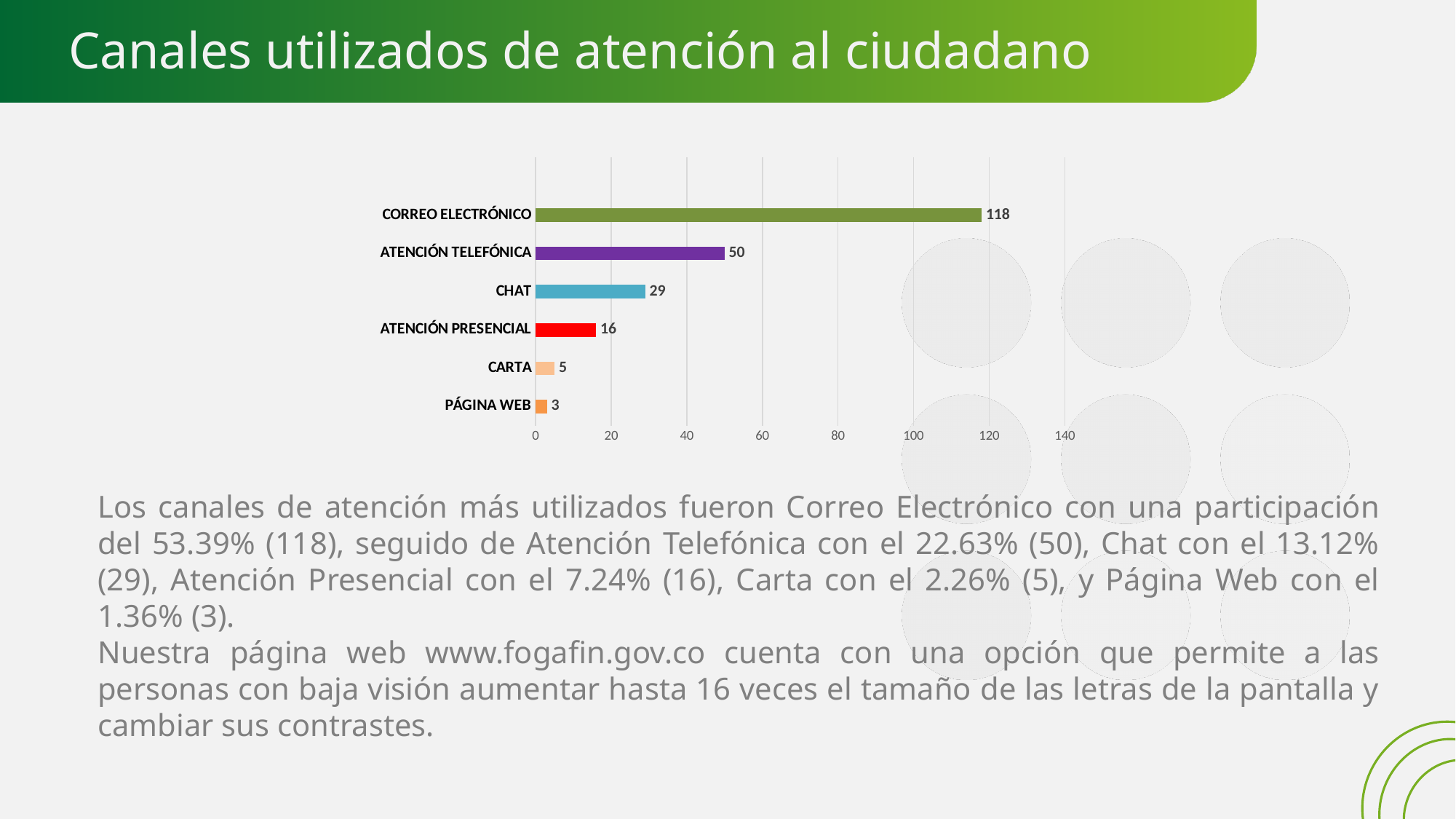
What is the value for ATENCIÓN PRESENCIAL? 16 Which category has the lowest value? PÁGINA WEB Is the value for CORREO ELECTRÓNICO greater or less than 100? greater What is the difference between the values for CARTA and PÁGINA WEB? 2 What is the value for ATENCIÓN TELEFÓNICA? 50 What is the difference between the values for CORREO ELECTRÓNICO and ATENCIÓN TELEFÓNICA? 68 What is the value for CHAT? 29 Which category has the highest value? CORREO ELECTRÓNICO How many categories are shown in the chart? 6 Which is larger, the value for CHAT or the value for ATENCIÓN PRESENCIAL? CHAT What kind of chart is shown on the slide? bar chart What is the value for CORREO ELECTRÓNICO? 118